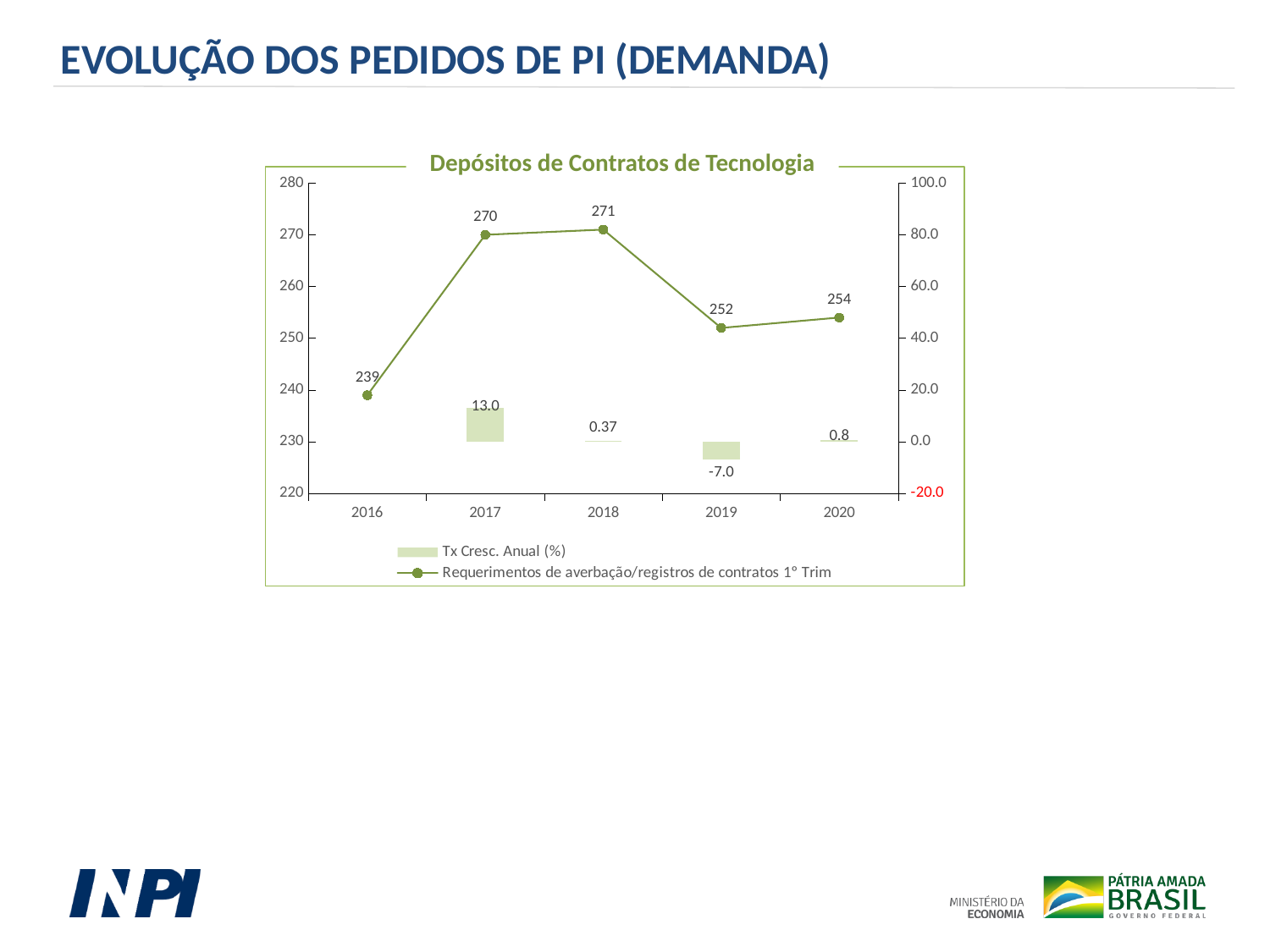
Which year has a larger Tx Cresc. Anual (%) value, 2017 or 2020? 2017 What kind of chart is used to show the Tx Cresc. Anual (%) series? Bar chart Which year has the highest value for Requerimentos de averbação/registros de contratos 1° Trim? 2018 What is the value of Requerimentos de averbação/registros de contratos 1° Trim for 2018? 271 How many years are shown on the x axis? 5 How many series does the legend list? 2 What is the value of Requerimentos de averbação/registros de contratos 1° Trim for 2016? 239 Does the Requerimentos de averbação/registros de contratos 1° Trim series rise or fall from 2018 to 2019? Fall What is the Tx Cresc. Anual (%) value for 2019? -7.0 What is the title of the chart? Depósitos de Contratos de Tecnologia What is the difference between the Requerimentos values for 2017 and 2016? 31 Which year has the lowest value for Requerimentos de averbação/registros de contratos 1° Trim? 2016